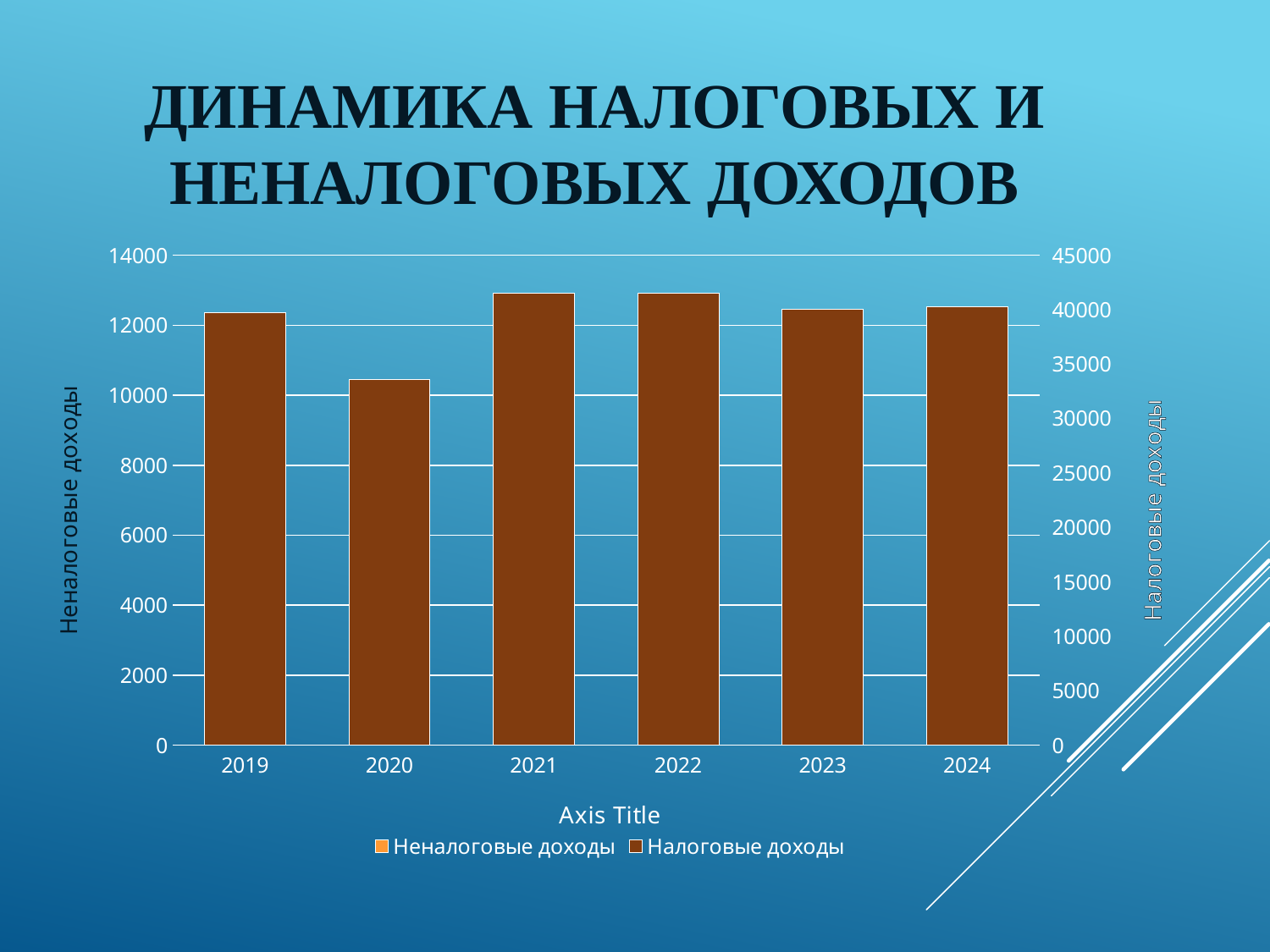
Is the bar for 2020 greater or less than 30000 on the right-hand axis? greater How many years are shown on the x axis of the chart? 6 What kind of chart is shown on the slide? bar chart Is the bar for 2021 greater or less than 40000 on the right-hand axis? greater Which bar is taller, 2020 or 2021? 2021 Which year has the lowest bar in the chart? 2020 Is the bar for 2022 greater or less than 40000 on the right-hand axis? greater What is the title of the chart's x axis? Axis Title How many series does the chart legend list? 2 Do the bars rise or fall from 2019 to 2020? fall Which bar is taller, 2019 or 2020? 2019